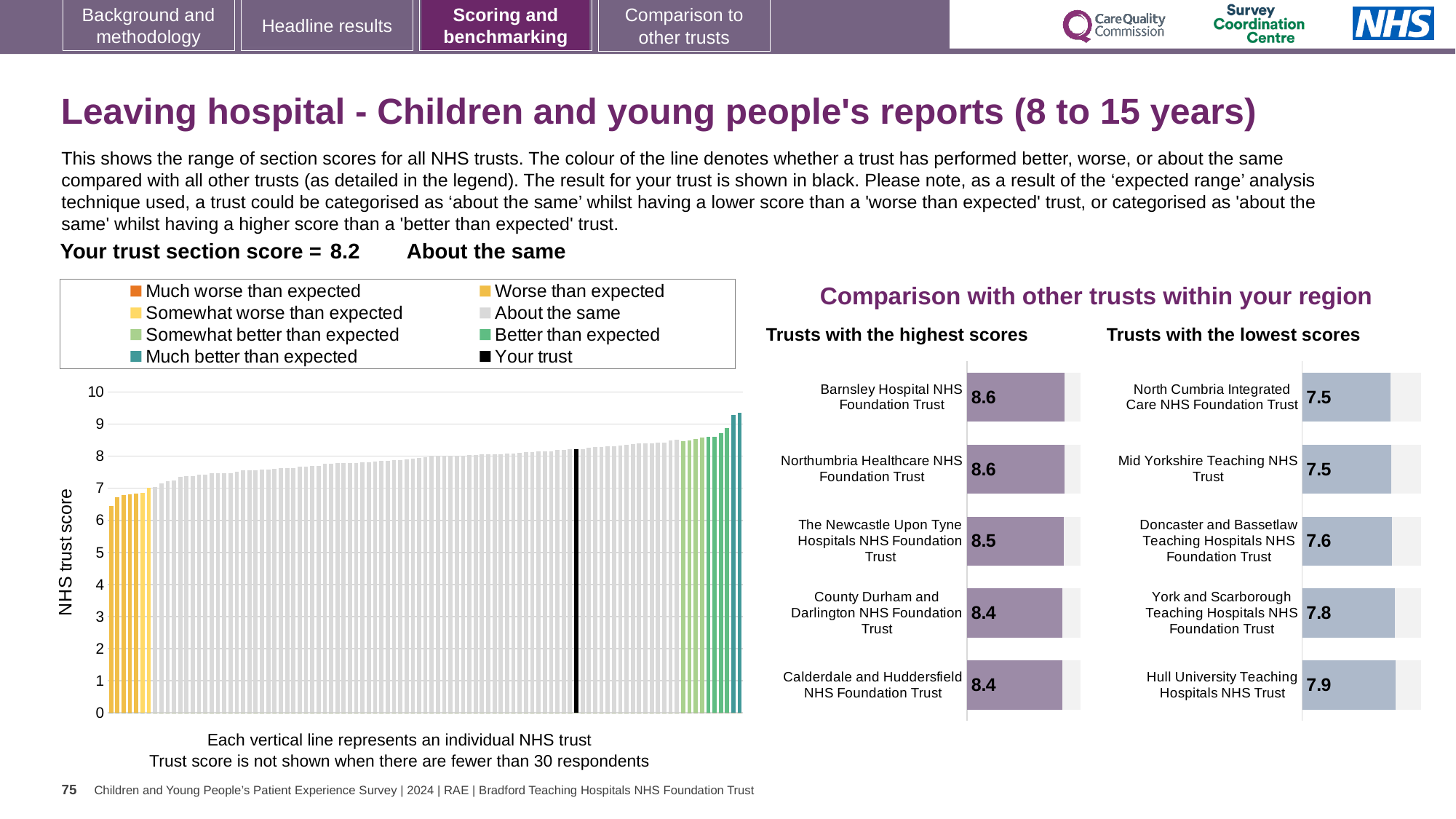
In the 'Trusts with the lowest scores' chart, which trust has the highest score? Hull University Teaching Hospitals NHS Trust In the 'Trusts with the highest scores' chart, what is the score for The Newcastle Upon Tyne Hospitals NHS Foundation Trust? 8.5 What kind of chart is the main NHS trust score chart on the left? bar chart In the 'Trusts with the highest scores' chart, what is the difference between the scores of Barnsley Hospital NHS Foundation Trust and Calderdale and Huddersfield NHS Foundation Trust? 0.2 In the main NHS trust score chart on the left, is the value of the highest bar greater or less than 9? greater How many entries does the legend of the main NHS trust score chart list? 8 In the 'Trusts with the lowest scores' chart, what is the difference between the scores of Hull University Teaching Hospitals NHS Trust and North Cumbria Integrated Care NHS Foundation Trust? 0.4 In the main NHS trust score chart on the left, is the value of the lowest bar greater or less than 7? less In the 'Trusts with the highest scores' chart, how many trusts are listed? 5 In the 'Trusts with the lowest scores' chart, what is the score for York and Scarborough Teaching Hospitals NHS Foundation Trust? 7.8 In the 'Trusts with the lowest scores' chart, which has the larger score: Hull University Teaching Hospitals NHS Trust or Doncaster and Bassetlaw Teaching Hospitals NHS Foundation Trust? Hull University Teaching Hospitals NHS Trust In the main NHS trust score chart on the left, do the bar values rise or fall from left to right? rise